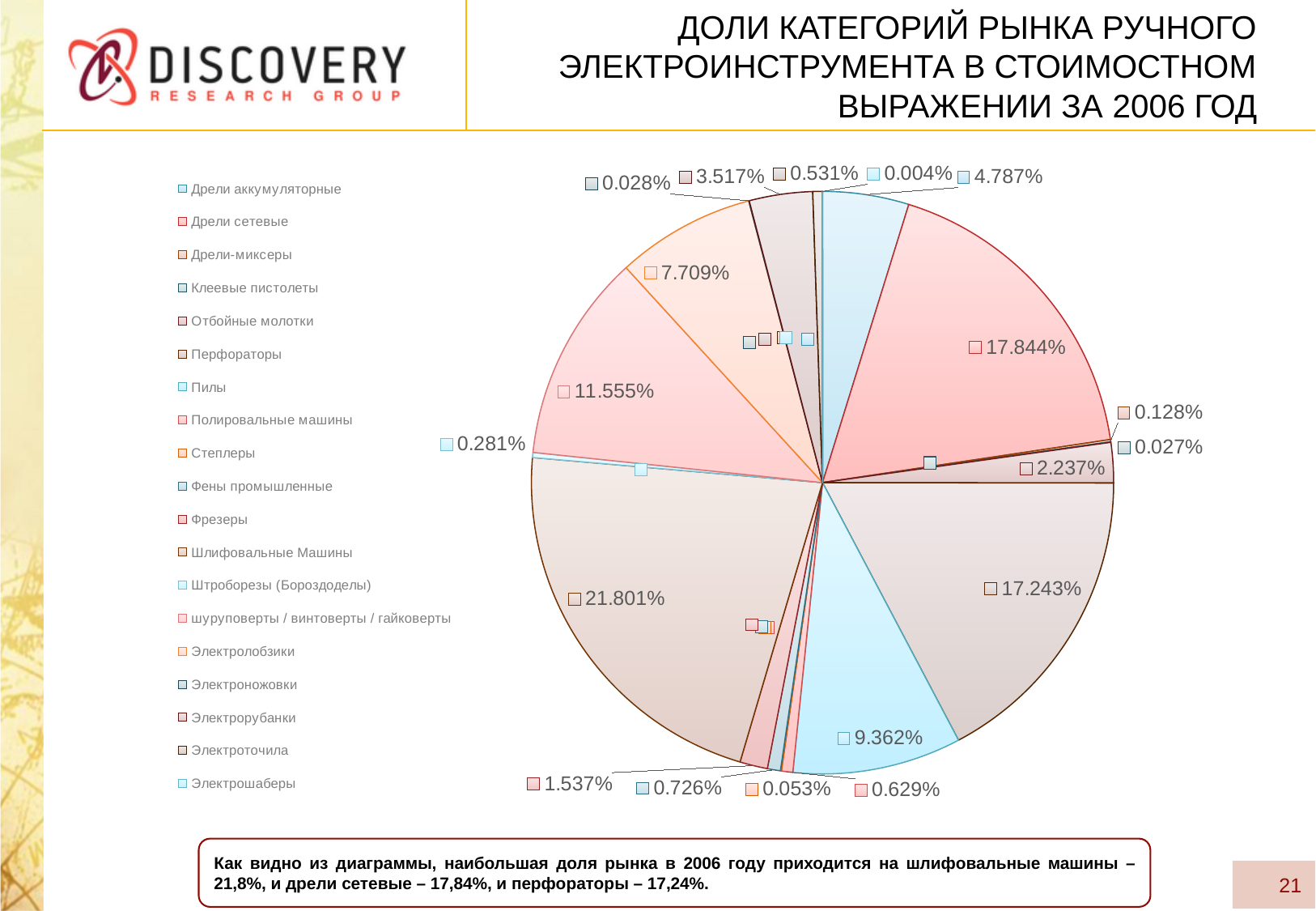
What is the smallest percentage value labelled on the pie chart? 0.004% What type of chart is shown on the slide? pie chart What is the title of the chart on the slide? Доли категорий рынка ручного электроинструмента в стоимостном выражении за 2006 год What is the difference between the shares of Дрели сетевые and Перфораторы? 0.601% What is the share shown for Дрели сетевые? 17.844% How many categories does the legend of the pie chart list? 19 What is the share shown for Шлифовальные машины? 21.801% Which category has the largest share of the market in the pie chart? Шлифовальные машины Which has the larger share, Дрели сетевые or Перфораторы? Дрели сетевые What is the share shown for Перфораторы? 17.243% What is the difference between the shares of Шлифовальные машины and Дрели сетевые? 3.957% What is the combined share of Шлифовальные машины, Дрели сетевые and Перфораторы? 56.888%